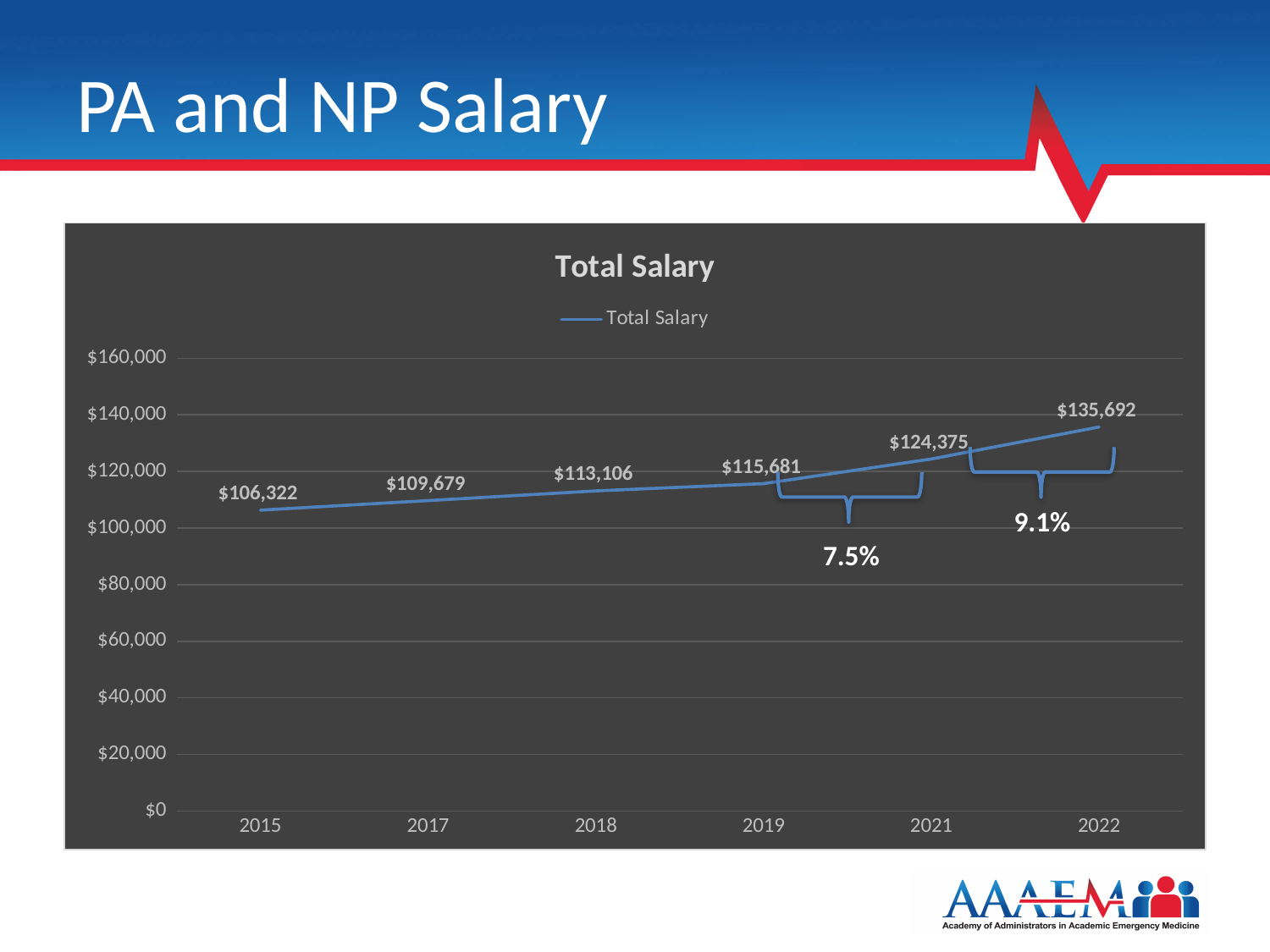
What kind of chart is shown on the slide? line chart What is the Total Salary value for 2019? $115,681 Which year has the highest Total Salary? 2022 What is the Total Salary value for 2022? $135,692 Does the Total Salary rise or fall from 2015 to 2022? rise How many years are plotted on the x axis? 6 Is the Total Salary for 2021 greater or less than $120,000? greater Which year has the lowest Total Salary? 2015 What is the Total Salary value for 2015? $106,322 What is the difference in Total Salary between 2018 and 2017? $3,427 What is the difference in Total Salary between 2022 and 2021? $11,317 Which year has a larger Total Salary, 2017 or 2019? 2019